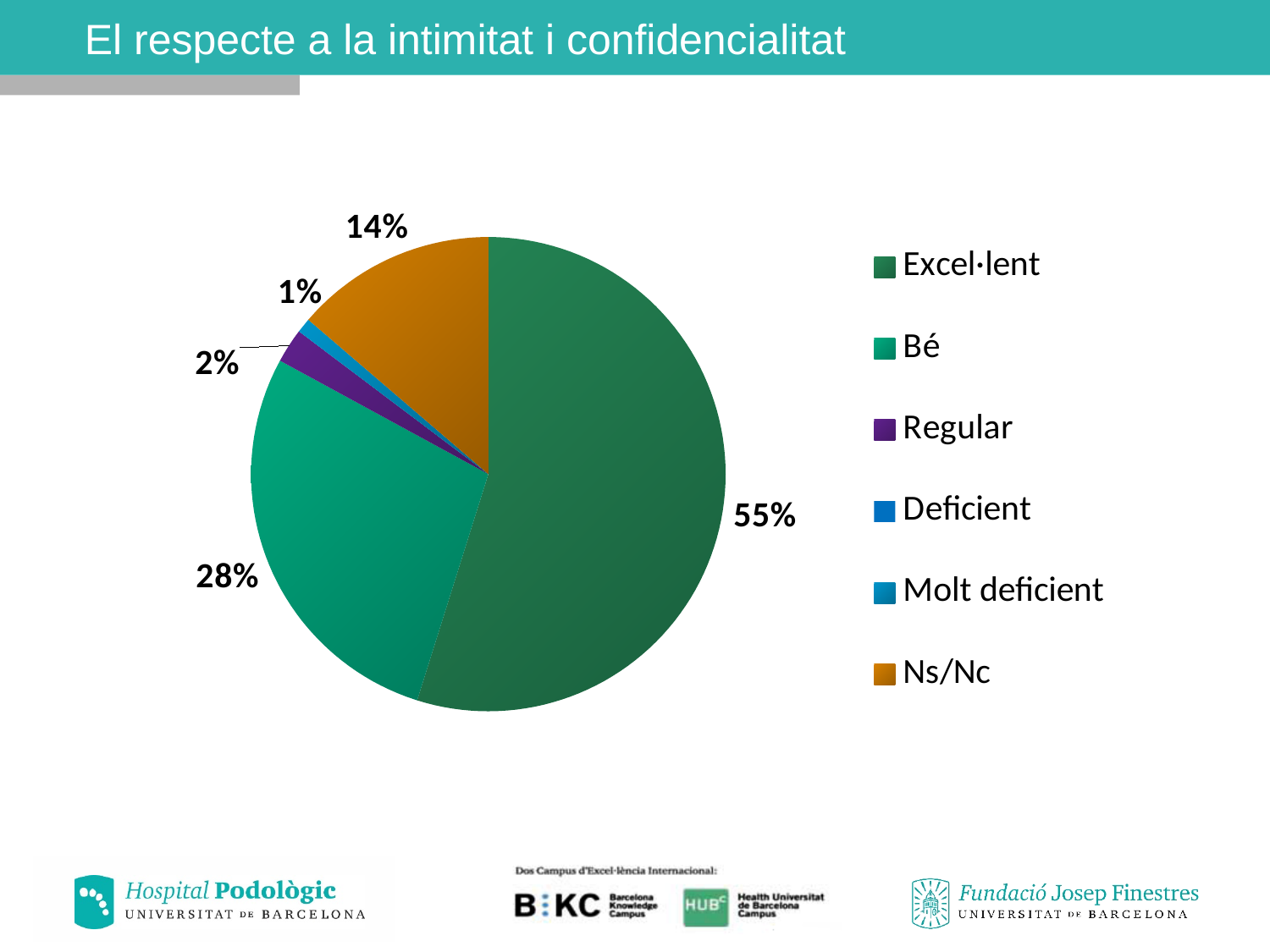
Which is larger, the Bé slice or the Ns/Nc slice? Bé What type of chart is shown on the slide? Pie chart What percentage of the pie chart corresponds to Bé? 28% Which category has the largest slice of the pie chart? Excel·lent How many entries does the legend list? 6 What is the difference in percentage points between the Excel·lent and Bé slices? 27 What percentage of the pie chart is labelled Excel·lent? 55% What percentage does the Ns/Nc slice represent? 14% What is the combined share of the Excel·lent and Bé slices? 83% What percentage does the Regular slice represent? 2% What is the title of the slide containing the chart? El respecte a la intimitat i confidencialitat Which legend entry is shown in orange? Ns/Nc